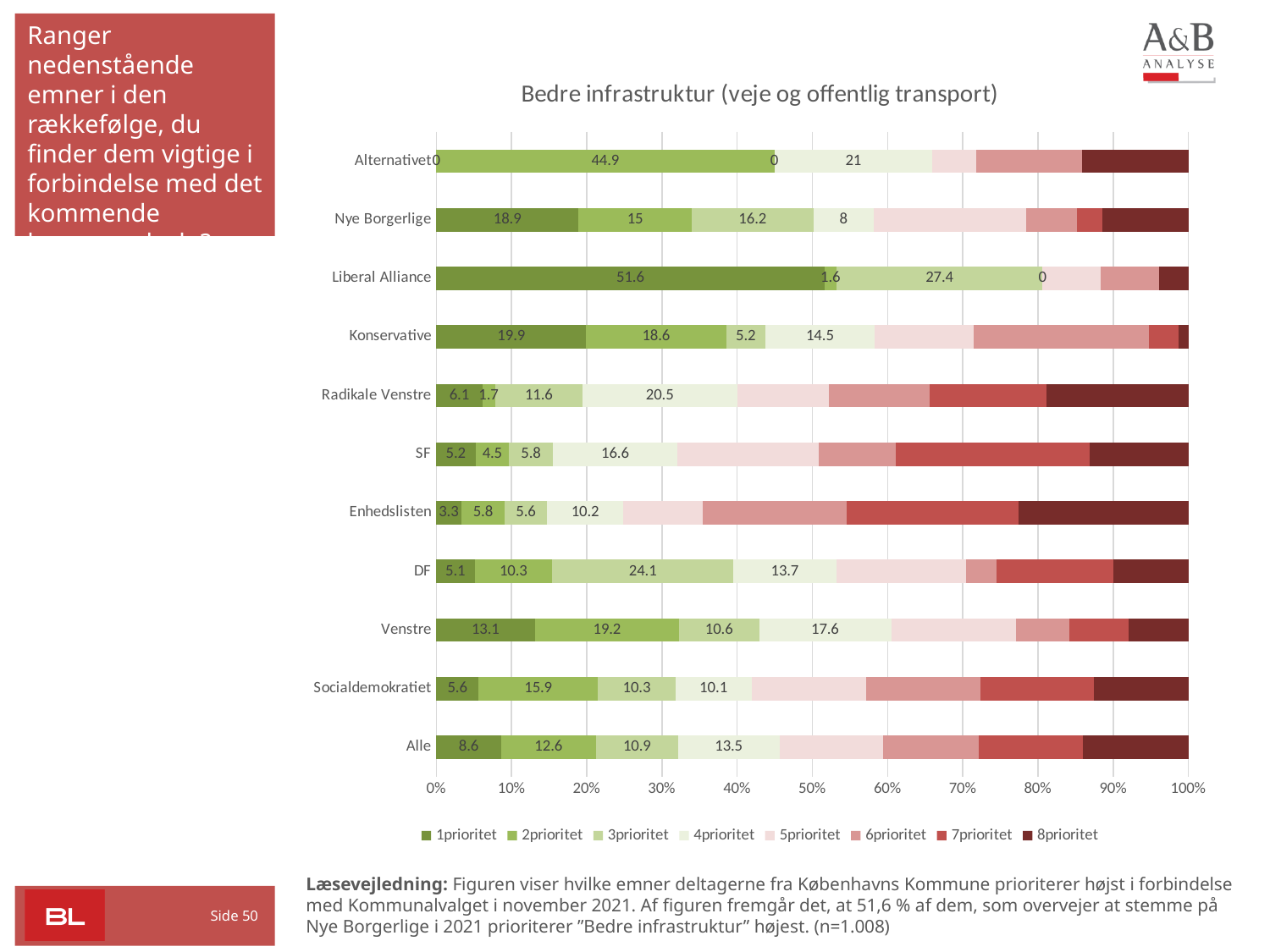
Which category has the lowest 1prioritet value? Alternativet What is the title of the chart? Bedre infrastruktur (veje og offentlig transport) How many series does the legend list? 8 What is the 3prioritet value for DF? 24.1 How many categories (parties/groups) are shown on the vertical axis? 11 What type of chart is shown on the slide? Stacked bar chart What is the 2prioritet value for Alternativet? 44.9 What is the 4prioritet value for Alle? 13.5 Which category has the highest 1prioritet value? Liberal Alliance What is the 1prioritet value for Liberal Alliance? 51.6 What is the difference between the 1prioritet values for Konservative and Nye Borgerlige? 1 Which has a larger 2prioritet value, Venstre or Socialdemokratiet? Venstre